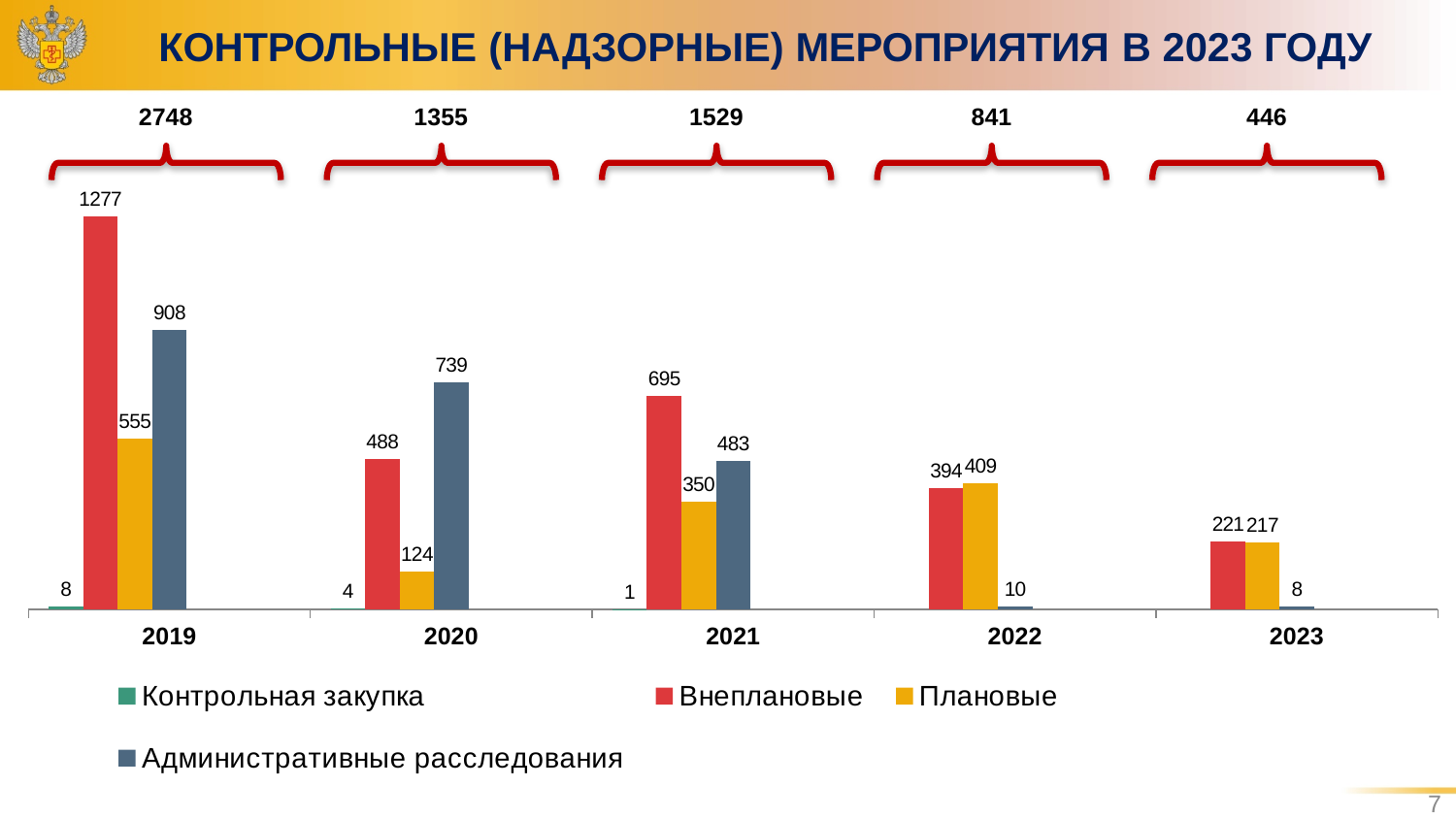
In which year is the value for Внеплановые the highest? 2019 How many series does the legend list? 4 What is the value for Плановые in 2021? 350 What is the value for Внеплановые in 2019? 1277 What is the value for Административные расследования in 2020? 739 What type of chart is shown on the slide? bar chart What is the total shown above the 2021 group of bars? 1529 In which year is the value for Плановые the lowest? 2020 What is the difference between Внеплановые and Плановые in 2019? 722 How does the value for Административные расследования change from 2019 to 2023? It falls Which is larger in 2022: Внеплановые or Плановые? Плановые What is the value for Контрольная закупка in 2020? 4